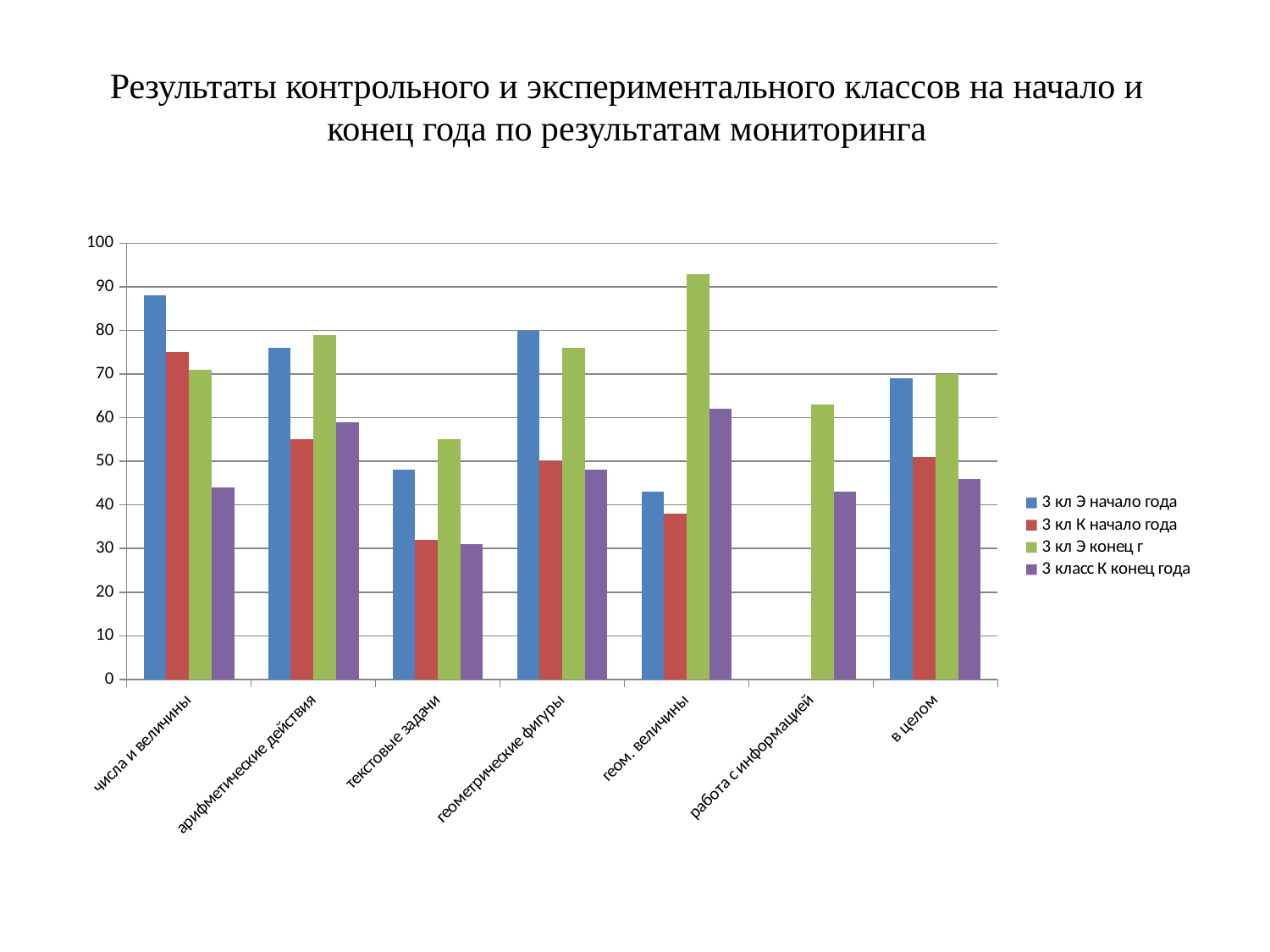
Is the value of "3 кл Э начало года" for "геометрические фигуры" greater or less than 70? greater For "числа и величины", which is larger: the value of "3 кл Э начало года" or "3 кл Э конец г"? 3 кл Э начало года For which category is the value of the series "3 кл Э конец г" the highest? геом. величины For which category is the value of the series "3 кл Э начало года" the highest? числа и величины How many categories are shown along the x axis of the chart? 7 Is the value of "3 кл Э конец г" for "геом. величины" greater or less than 90? greater What kind of chart is shown on the slide? bar chart For which category is the value of the series "3 кл К начало года" the lowest? текстовые задачи Is the value of "3 класс К конец года" for "числа и величины" greater or less than 50? less How many series does the chart's legend list? 4 For "геом. величины", which is larger: the value of "3 кл Э конец г" or "3 класс К конец года"? 3 кл Э конец г Which category has bars only for the two end-of-year series ("3 кл Э конец г" and "3 класс К конец года")? работа с информацией